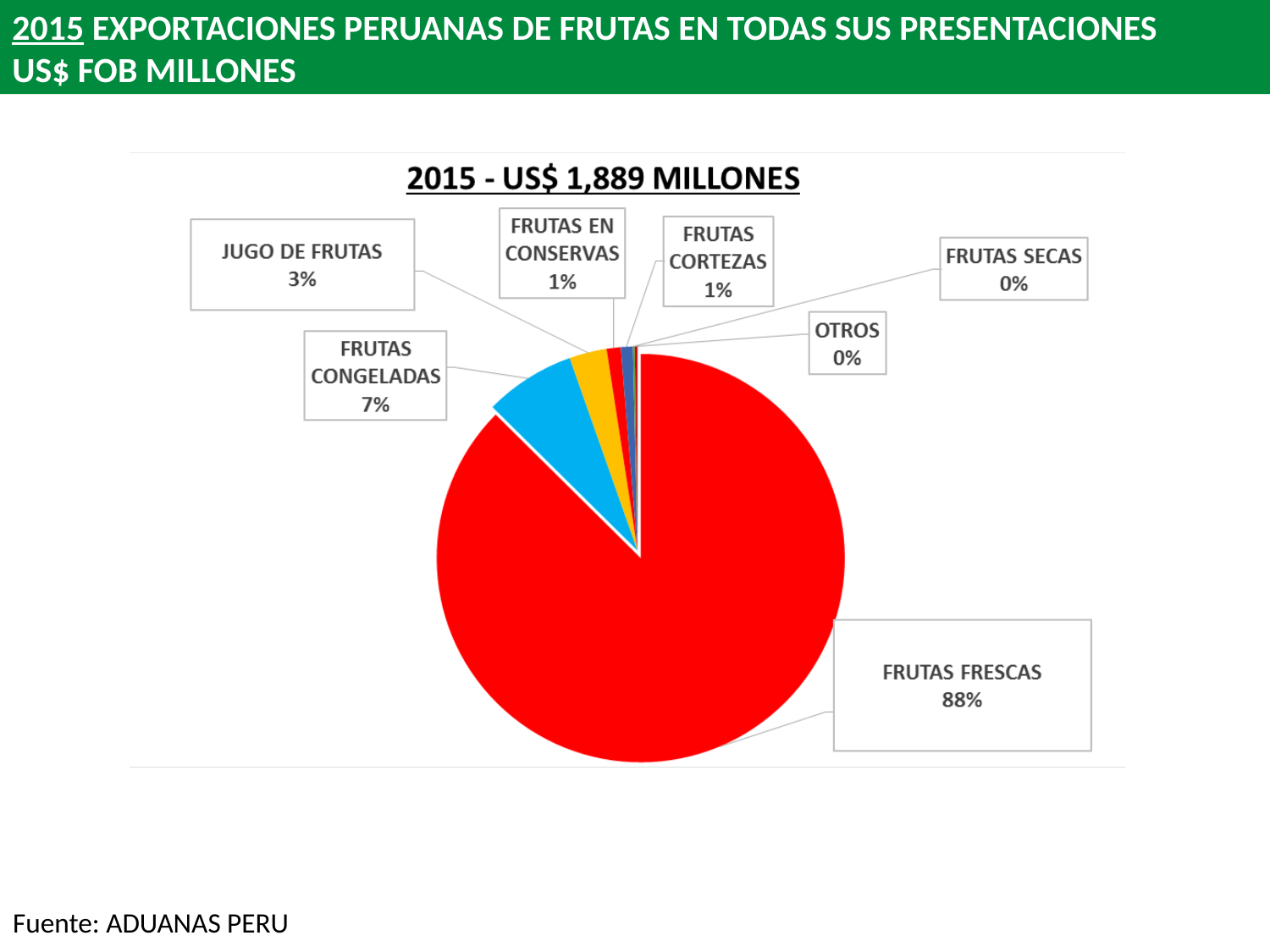
What share of the pie does FRUTAS FRESCAS represent? 88% Which has a larger share, FRUTAS CONGELADAS or JUGO DE FRUTAS? FRUTAS CONGELADAS Which category has the largest share of the pie? FRUTAS FRESCAS What total value in US$ millions is stated in the chart title? US$ 1,889 MILLONES What is the percentage shown for FRUTAS EN CONSERVAS? 1% What is the percentage shown for FRUTAS CONGELADAS? 7% How many categories are labelled on the pie chart? 7 What is the difference in percentage points between FRUTAS FRESCAS and FRUTAS CONGELADAS? 81 percentage points What is the percentage shown for FRUTAS SECAS? 0% What is the percentage shown for JUGO DE FRUTAS? 3% What kind of chart is shown on the slide? pie chart What colour is the FRUTAS FRESCAS slice? red